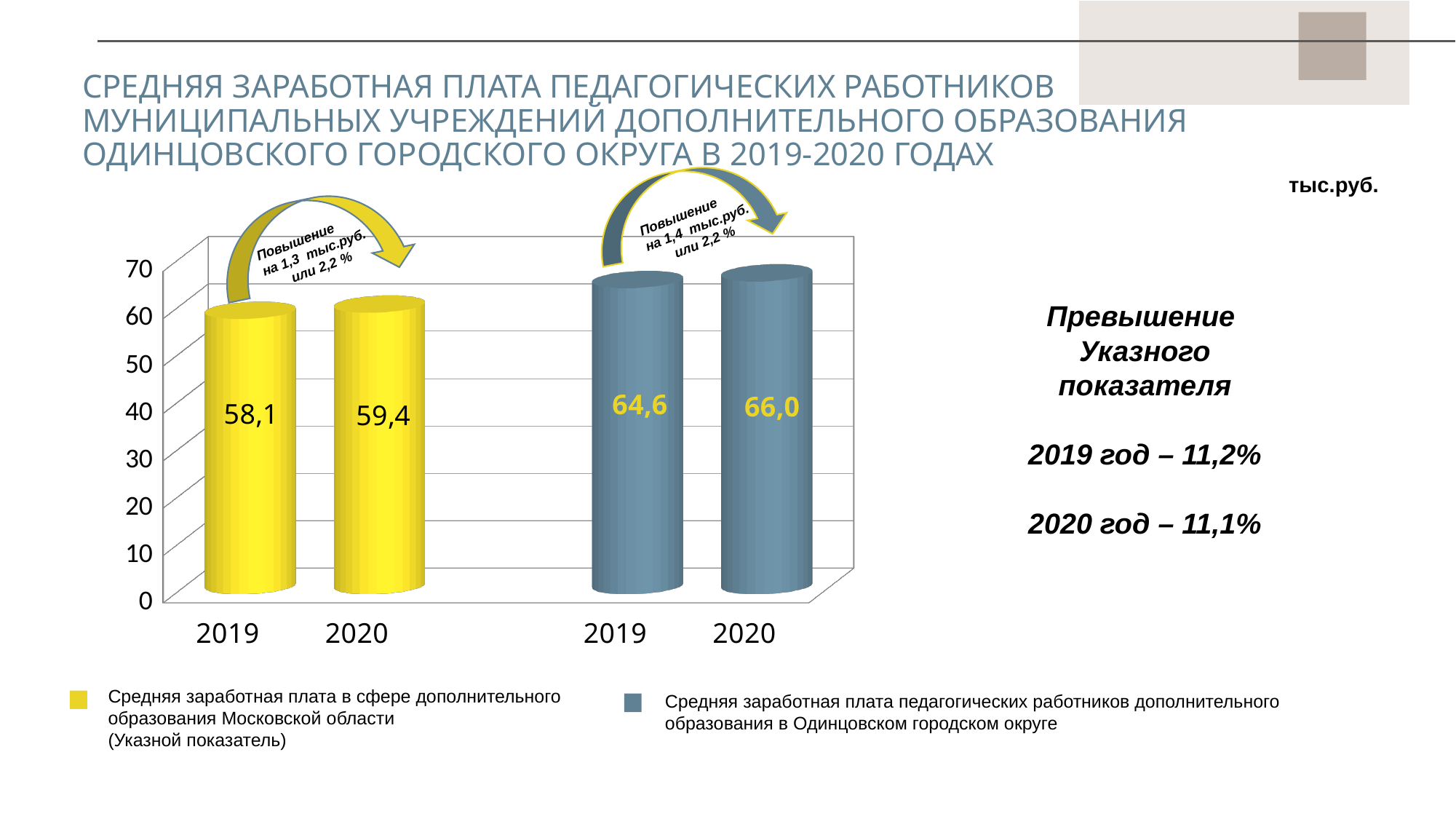
What unit of measurement is indicated for the chart values? тыс.руб. What is the average salary in the sphere of additional education of the Moscow region (Указной показатель) for 2020? 59,4 What type of chart is shown on the slide? Bar chart What is the average salary of pedagogical workers of additional education in the Odintsovo city district for 2020? 66,0 Which bar shows the lowest value on the chart? Moscow region (Указной показатель), 2019 (58,1) Which bar shows the highest value on the chart? Odintsovo city district, 2020 (66,0) What is the average salary of pedagogical workers of additional education in the Odintsovo city district for 2019? 64,6 By how much did the Moscow region (Указной показатель) average salary increase from 2019 to 2020? 1,3 Which is larger in 2020: the Moscow region indicator or the Odintsovo city district salary? Odintsovo city district What is the average salary in the sphere of additional education of the Moscow region (Указной показатель) for 2019? 58,1 By how much did the Odintsovo city district average salary increase from 2019 to 2020? 1,4 Is the value for the Odintsovo city district in 2019 greater or less than 60? greater